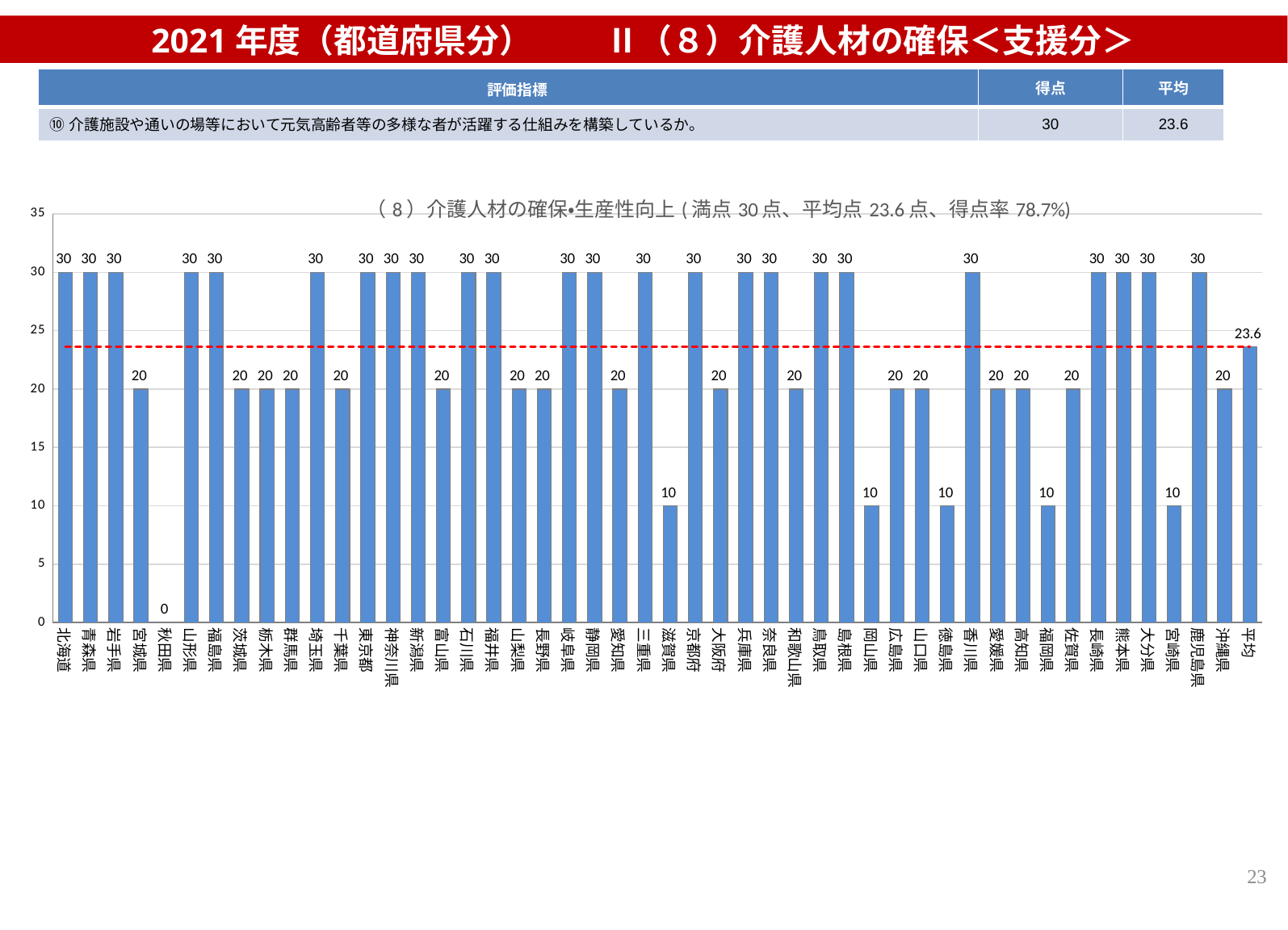
How many bars are plotted in the chart? 48 What is the value for 秋田県? 0 What is the value for 平均? 23.6 What kind of chart is shown on the slide? bar chart What is the value for 滋賀県? 10 What is the difference between the values for 鹿児島県 and 宮崎県? 20 What is the difference between the values for 北海道 and 宮城県? 10 What is the value for 沖縄県? 20 Which category has the lowest value? 秋田県 Which has the larger value, 岡山県 or 広島県? 広島県 What is the title of the chart? （8）介護人材の確保•生産性向上（満点 30 点、平均点 23.6 点、得点率 78.7%） What value does the red dashed horizontal line mark? 23.6